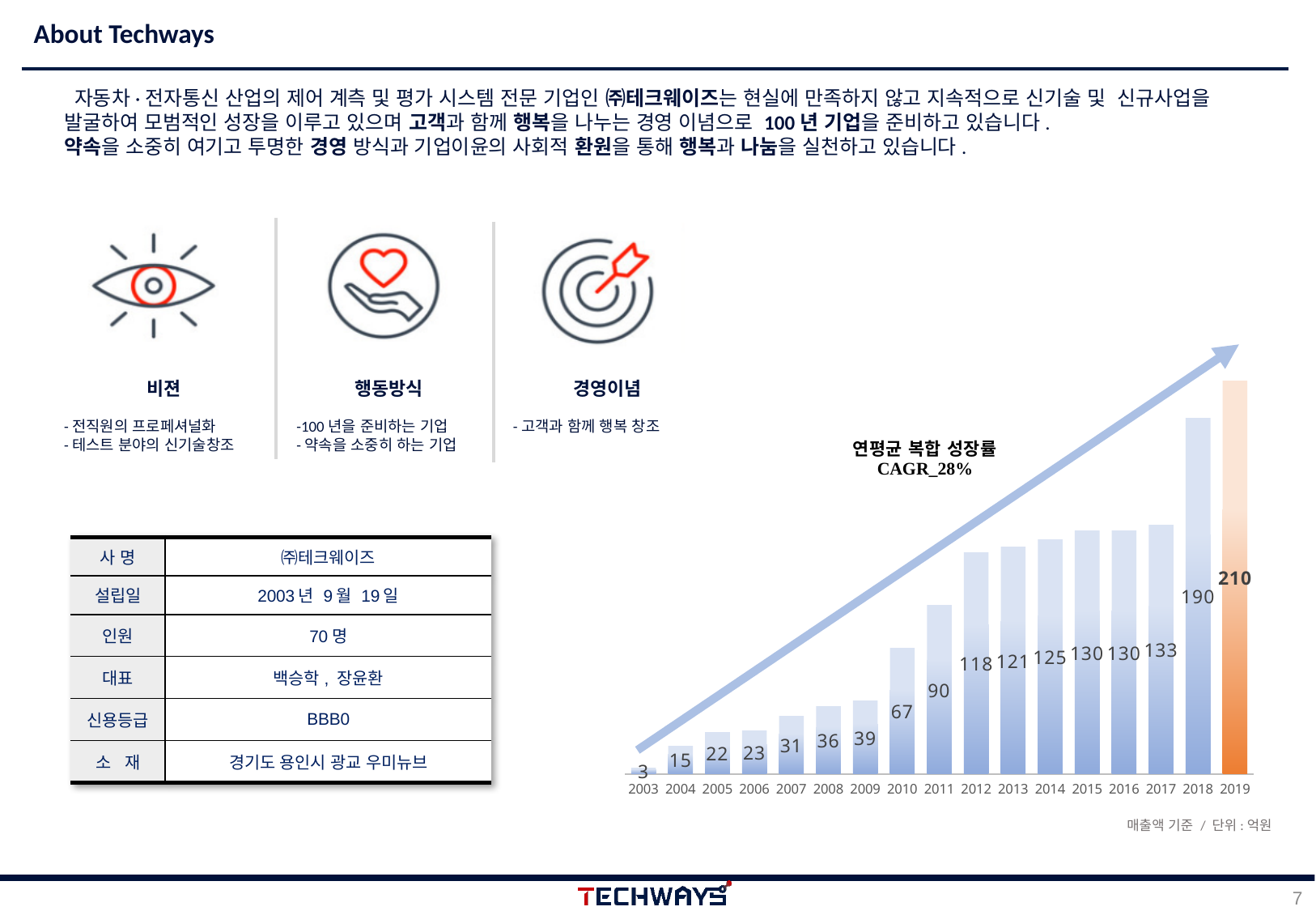
What is the value for 2003 in the bar chart? 3 Which year has the highest value in the bar chart? 2019 What is the value for 2011 in the bar chart? 90 What is the value for 2018 in the bar chart? 190 What CAGR is stated next to the bar chart? 28% Which year has the lowest value in the bar chart? 2003 What is the difference between the values for 2011 and 2010 in the bar chart? 23 What kind of chart is shown on the slide? bar chart Which is larger in the bar chart, the value for 2012 or the value for 2009? 2012 Do the values in the bar chart generally rise or fall from 2003 to 2019? rise What is the difference between the values for 2019 and 2018 in the bar chart? 20 How many years are shown on the x axis of the bar chart? 17